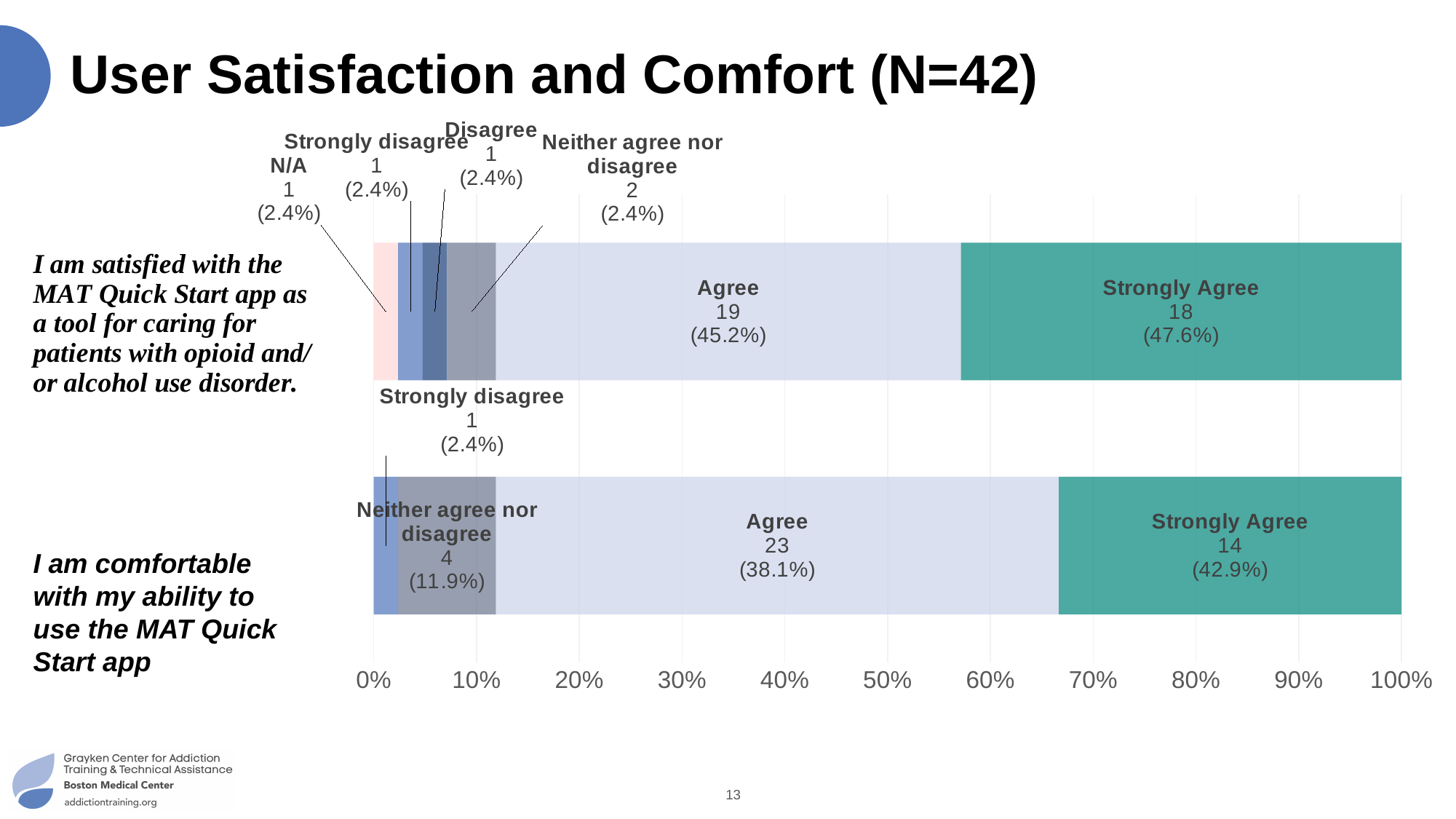
For the statement 'I am satisfied with the MAT Quick Start app...', how many respondents chose Agree? 19 For the statement 'I am comfortable with my ability to use the MAT Quick Start app', how many respondents chose Strongly Agree? 14 What is the title of the slide containing the chart? User Satisfaction and Comfort (N=42) For the statement 'I am satisfied with the MAT Quick Start app...', how many respondents answered N/A? 1 How many survey statements (bars) are plotted in the chart? 2 For the statement 'I am comfortable with my ability to use the MAT Quick Start app', how many respondents chose Neither agree nor disagree? 4 What kind of chart is shown on the slide? Stacked bar chart For the statement 'I am comfortable with my ability to use the MAT Quick Start app', which response category has the most respondents? Agree For the statement 'I am satisfied with the MAT Quick Start app...', what percentage chose Strongly Agree? 47.6% For the statement 'I am comfortable with my ability to use the MAT Quick Start app', how many more respondents chose Agree than Strongly Agree? 9 For the statement 'I am comfortable with my ability to use the MAT Quick Start app', what percentage chose Neither agree nor disagree? 11.9% For the statement 'I am comfortable with my ability to use the MAT Quick Start app', which has more respondents: Agree or Strongly Agree? Agree